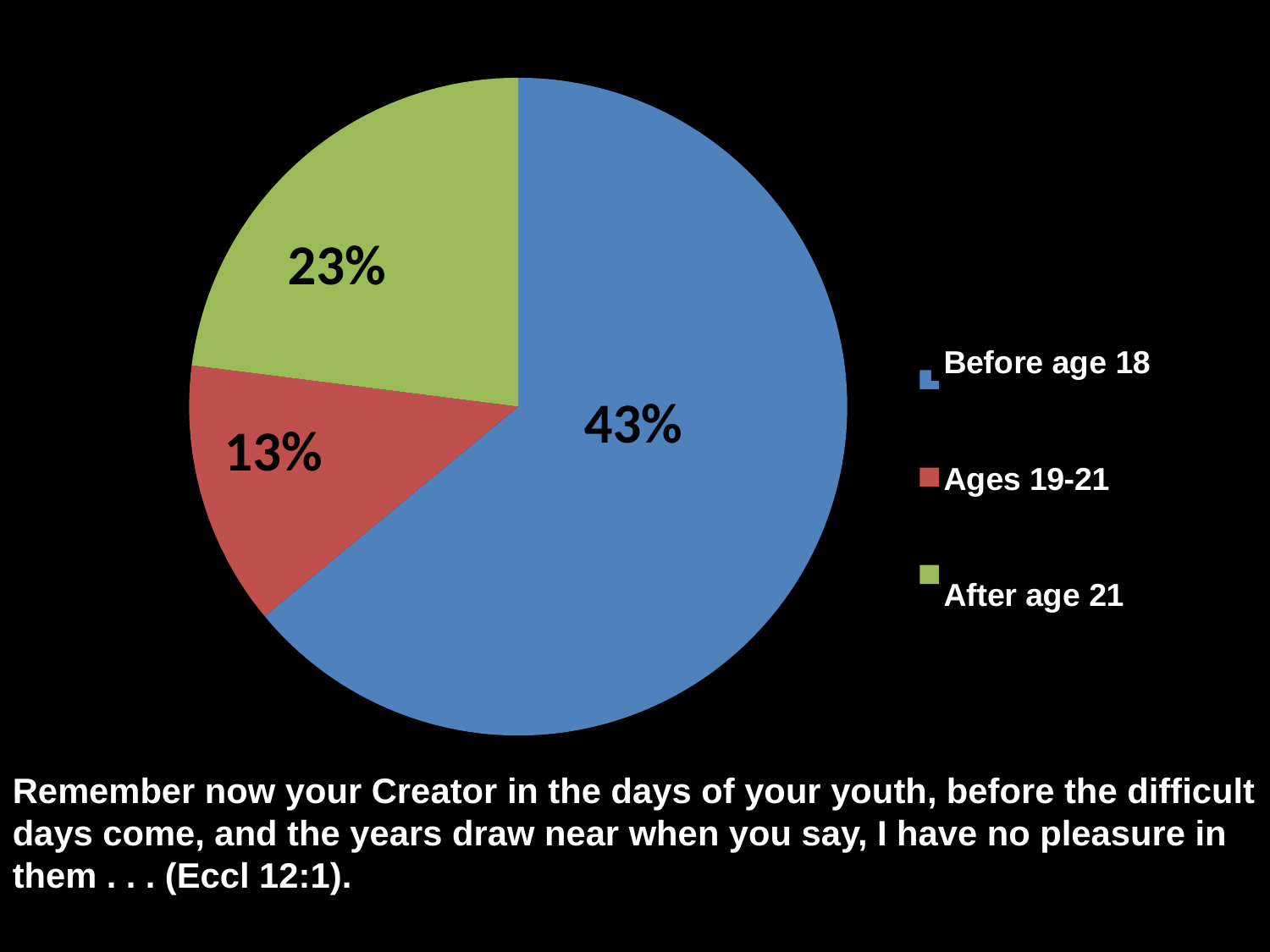
Which is larger, the value for After age 21 or the value for Ages 19-21? After age 21 What colour is the slice for Ages 19-21? red What is the value for After age 21? 23% What is the value for Before age 18? 43% Which category does the green slice represent? After age 21 How many slices does the pie chart have? 3 What kind of chart is shown on the slide? pie chart Which category has the smallest slice? Ages 19-21 What is the difference between the values for Before age 18 and After age 21? 20% What is the value for Ages 19-21? 13% What is the difference between the values for After age 21 and Ages 19-21? 10% Which category has the largest slice? Before age 18